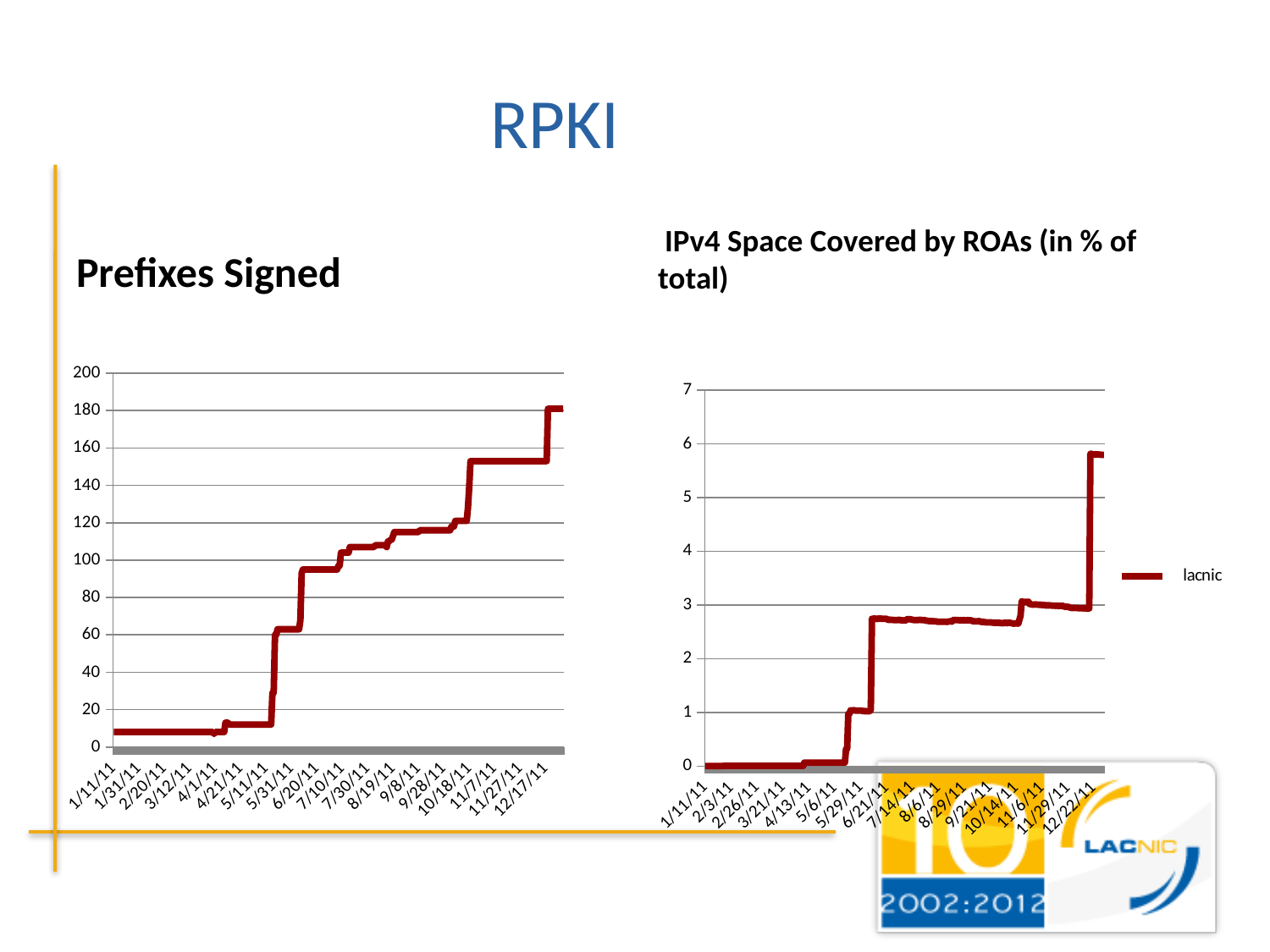
In the "Prefixes Signed" chart, is the value at 11/7/11 greater or less than 140? greater What kind of chart is the "Prefixes Signed" chart? line chart What is the legend entry shown on the "IPv4 Space Covered by ROAs (in % of total)" chart? lacnic In the "IPv4 Space Covered by ROAs (in % of total)" chart, do the values rise or fall over time? rise What kind of chart is the "IPv4 Space Covered by ROAs (in % of total)" chart? line chart In the "IPv4 Space Covered by ROAs (in % of total)" chart, is the value at 12/22/11 greater or less than 5? greater In the "Prefixes Signed" chart, is the value at 1/11/11 greater or less than 20? less In the "Prefixes Signed" chart, do the values rise or fall along the x axis from 1/11/11 to 12/17/11? rise How many series does the legend of the "IPv4 Space Covered by ROAs (in % of total)" chart list? 1